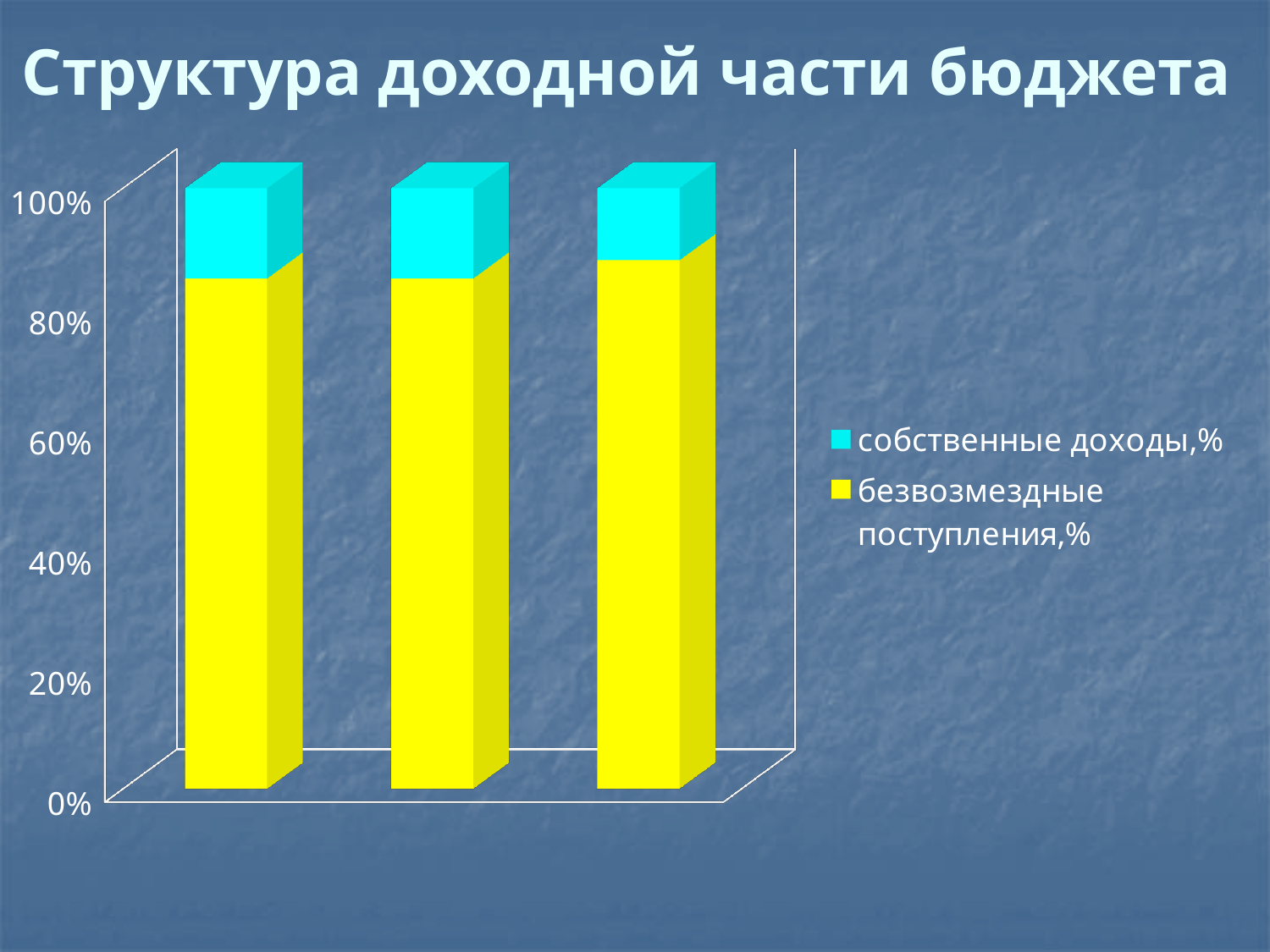
Is the value for безвозмездные поступления,% in the middle bar greater or less than 60%? greater How many bars are plotted in the chart? 3 Which series is shown in yellow according to the legend? безвозмездные поступления,% How many series does the legend list? 2 What kind of chart is shown on the slide? stacked bar chart Is the value for безвозмездные поступления,% in the leftmost bar greater or less than 80%? greater What is the total height of each stacked bar on the percentage axis? 100% Is the value for собственные доходы,% in the rightmost bar greater or less than 20%? less In the leftmost bar, which series has the larger share: собственные доходы,% or безвозмездные поступления,%? безвозмездные поступления,% What is the title of the chart? Структура доходной части бюджета